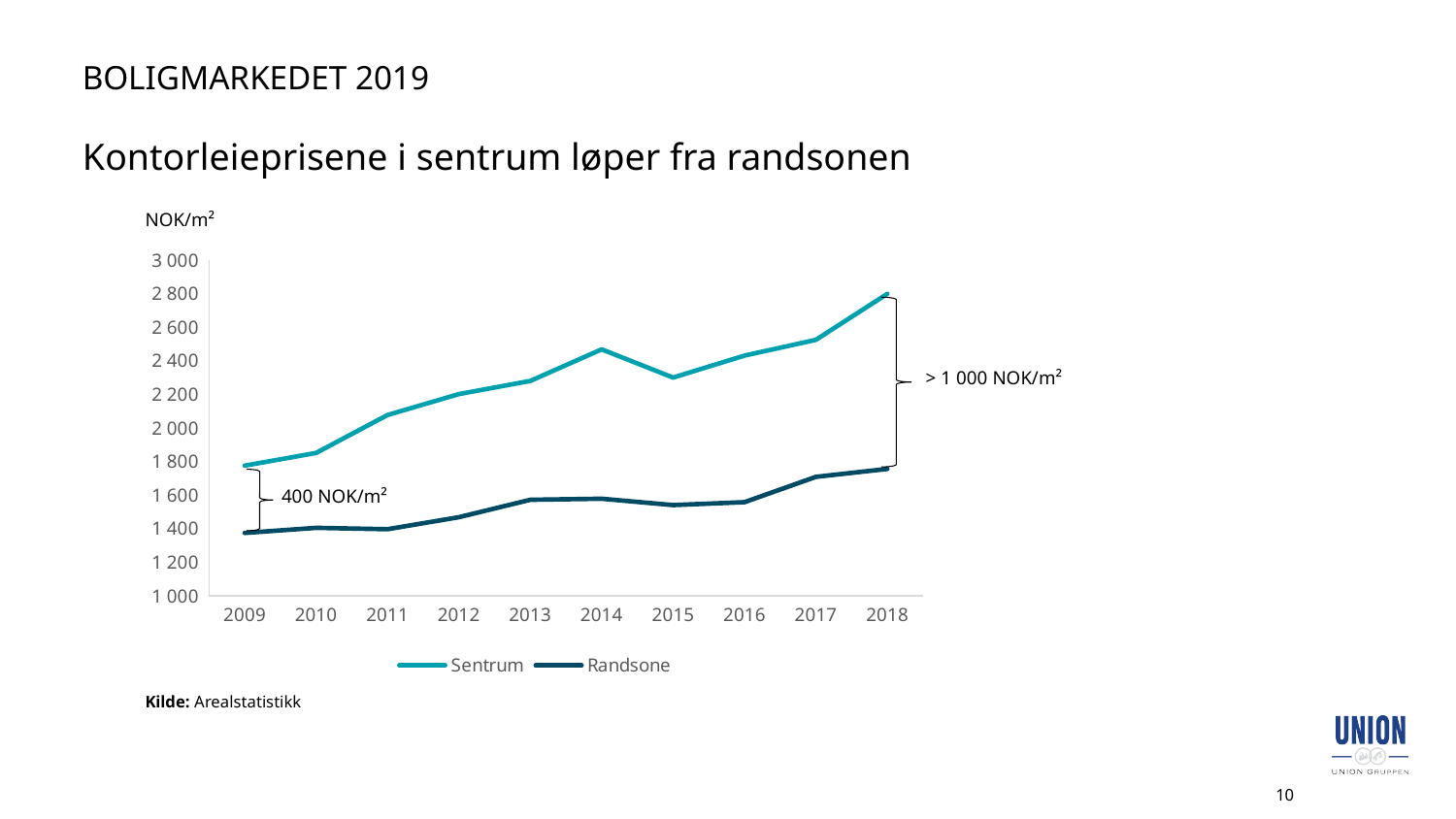
What kind of chart is shown on the slide? line chart Does the Sentrum series generally rise or fall from 2009 to 2018? rise What unit is shown above the y axis of the chart? NOK/m² What gap between the two series is annotated at 2009? 400 NOK/m² Is the value for Sentrum in 2018 greater or less than 2 600? greater In which year is the Randsone series at its lowest? 2009 In which year does the Sentrum series reach its highest value? 2018 How many years are plotted along the x axis? 10 How many series does the legend list? 2 Which series has the higher value in 2018, Sentrum or Randsone? Sentrum Is the value for Sentrum in 2015 greater or less than 2 400? less Is the value for Randsone in 2018 greater or less than 1 600? greater